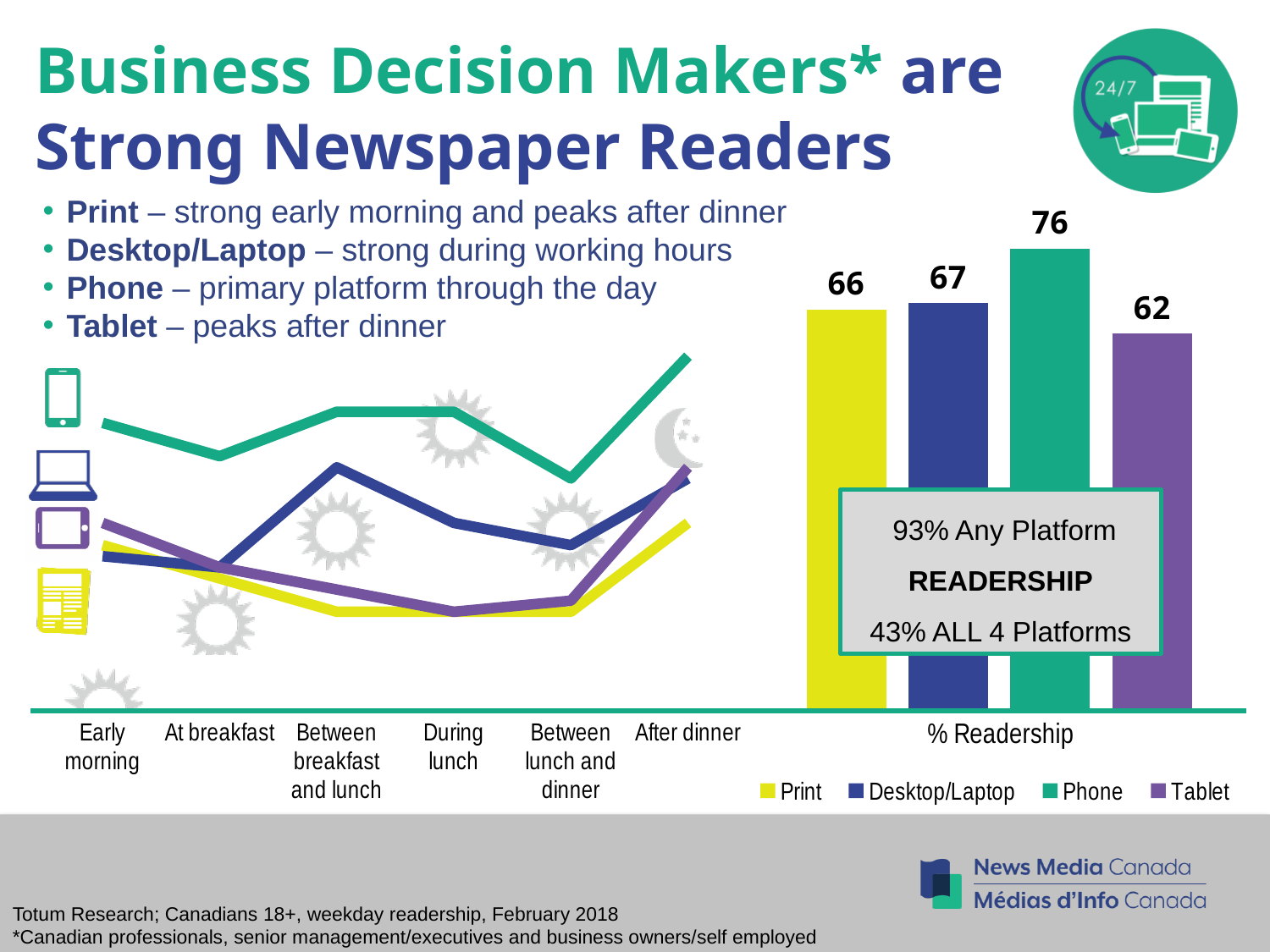
What kind of chart is the chart on the left of the slide? Line chart In the bar chart on the right, what is the % Readership value for Phone? 76 In the bar chart on the right, what is the % Readership value for Tablet? 62 How many series does the legend list for the charts on the slide? 4 In the bar chart on the right, which platform has the highest % Readership? Phone How many bars are shown in the % Readership bar chart on the right? 4 How many time-of-day categories are shown on the x axis of the line chart on the left? 6 In the bar chart on the right, which has a higher % Readership, Print or Desktop/Laptop? Desktop/Laptop In the line chart on the left, does the Phone line rise or fall from 'Between lunch and dinner' to 'After dinner'? Rise In the bar chart on the right, what is the % Readership value for Print? 66 In the bar chart on the right, which platform has the lowest % Readership? Tablet In the bar chart on the right, what is the difference between the Phone and Tablet % Readership values? 14